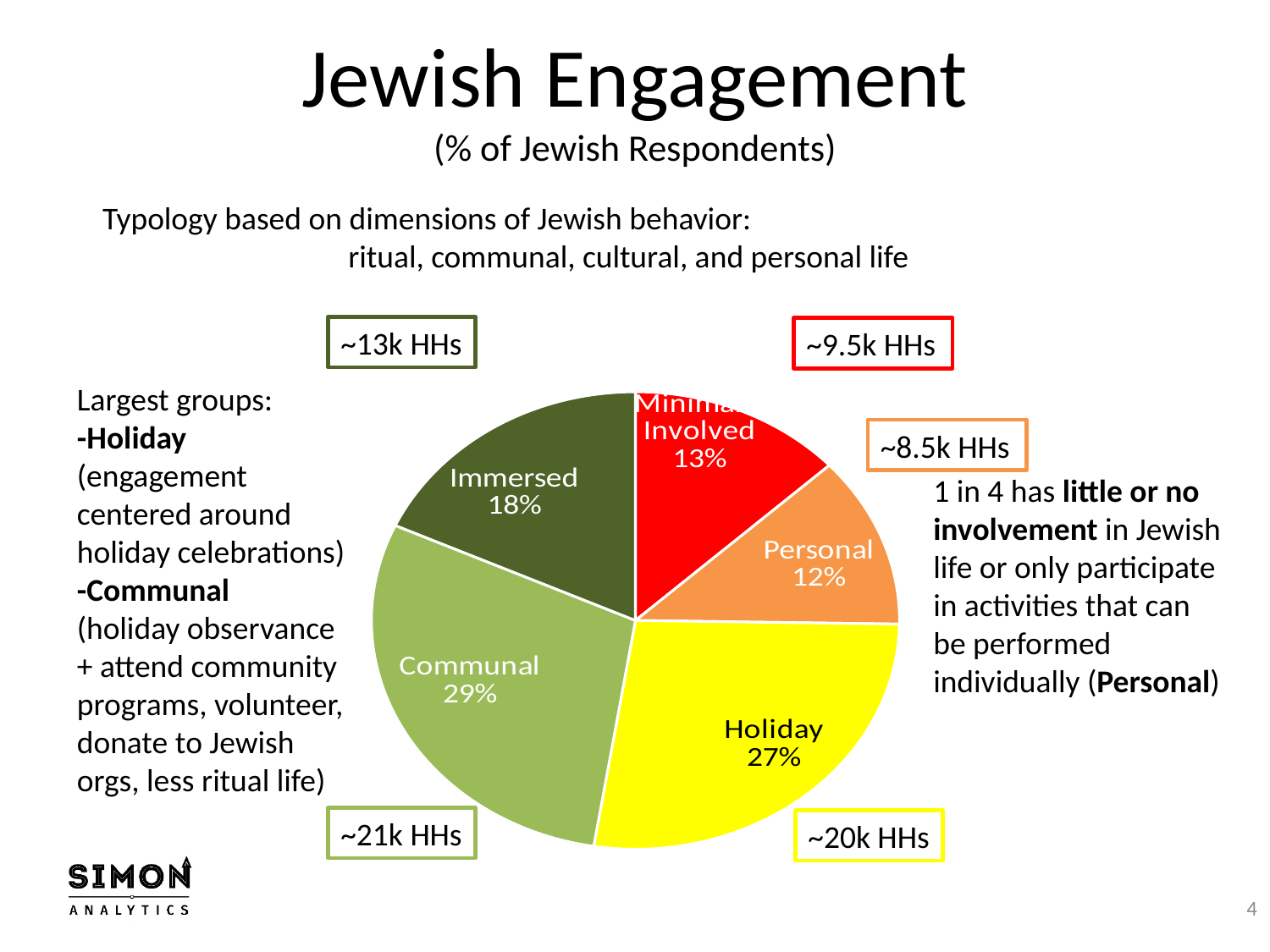
Which group has the smallest share of the pie chart? Personal What percentage is shown for the red slice of the pie chart? 13% How many percentage points larger is the Communal share than the Holiday share? 2 percentage points What is the title of the slide containing the pie chart? Jewish Engagement What kind of chart is shown on the slide? pie chart What percentage of Jewish respondents fall into the Immersed group? 18% Which is larger, the Immersed share or the Personal share? Immersed How many slices does the pie chart have? 5 What percentage of Jewish respondents fall into the Communal group? 29% What percentage of Jewish respondents fall into the Holiday group? 27% Which group has the largest share of the pie chart? Communal What percentage of Jewish respondents fall into the Personal group? 12%